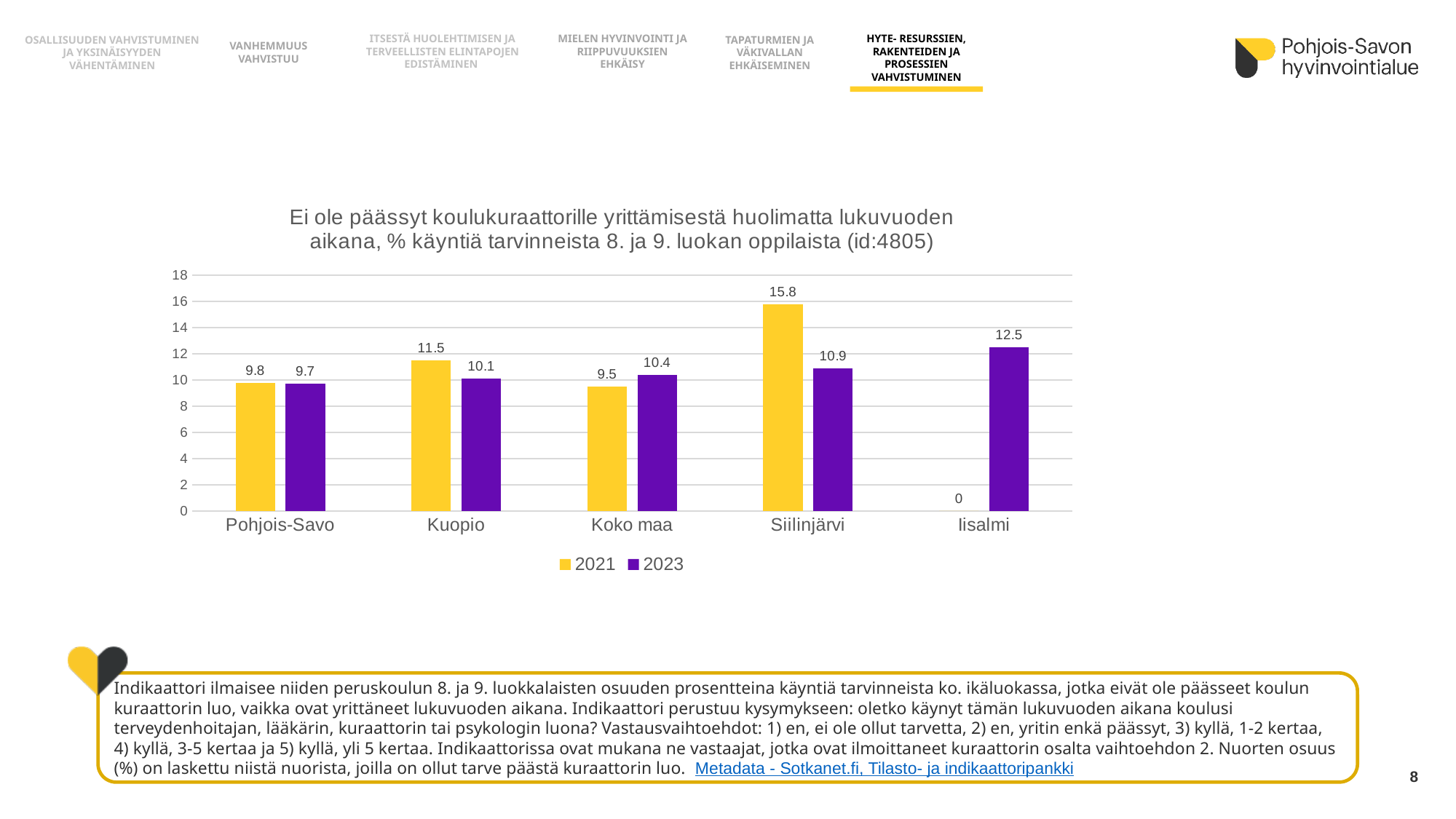
Which is larger for Kuopio, the 2021 value or the 2023 value? 2021 What kind of chart is shown on the slide? Bar chart Which category has the lowest 2023 value? Pohjois-Savo Which category has the highest 2021 value? Siilinjärvi What is the difference between the 2021 and 2023 values for Siilinjärvi? 4.9 What is the 2021 value for Kuopio? 11.5 What is the 2023 value for Iisalmi? 12.5 Which colour represents the 2023 series? Purple What is the 2023 value for Koko maa? 10.4 How many categories are shown on the x axis? 5 What is the 2021 value for Siilinjärvi? 15.8 How many series does the legend list? 2